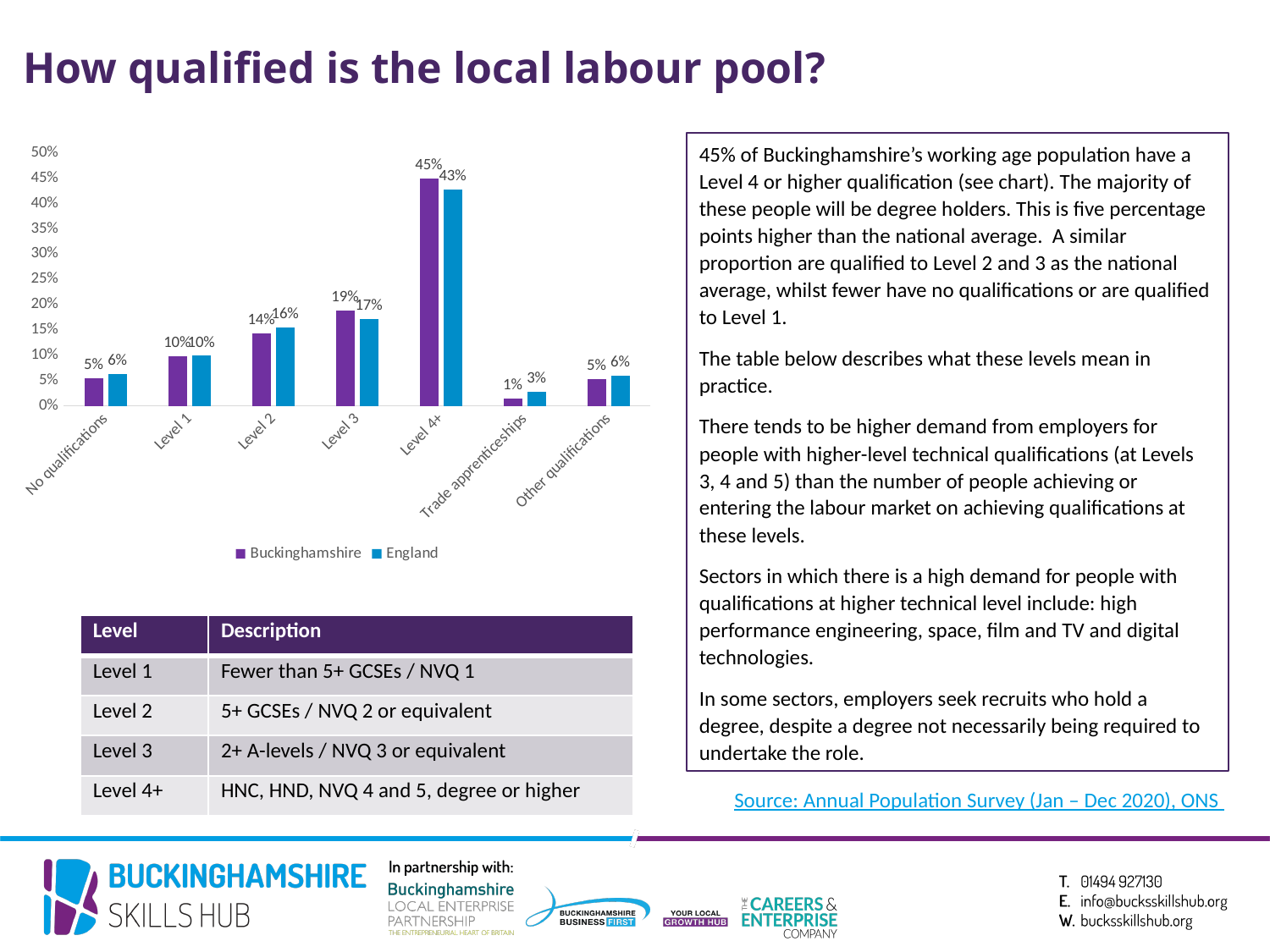
Which category has the lowest value for England? Trade apprenticeships Which category has the highest value for Buckinghamshire? Level 4+ What is the England value for Level 2? 16% Is the England value for Level 4+ greater or less than 40%? greater For Level 2, which is larger: the Buckinghamshire value or the England value? England What kind of chart is shown on the slide? Bar chart What is the Buckinghamshire value for Trade apprenticeships? 1% How many categories are shown on the x axis of the chart? 7 What is the Buckinghamshire value for Level 4+? 45% What is the England value for Level 3? 17% What is the difference between the Buckinghamshire and England values for Level 4+? 2% How many series does the chart legend list? 2